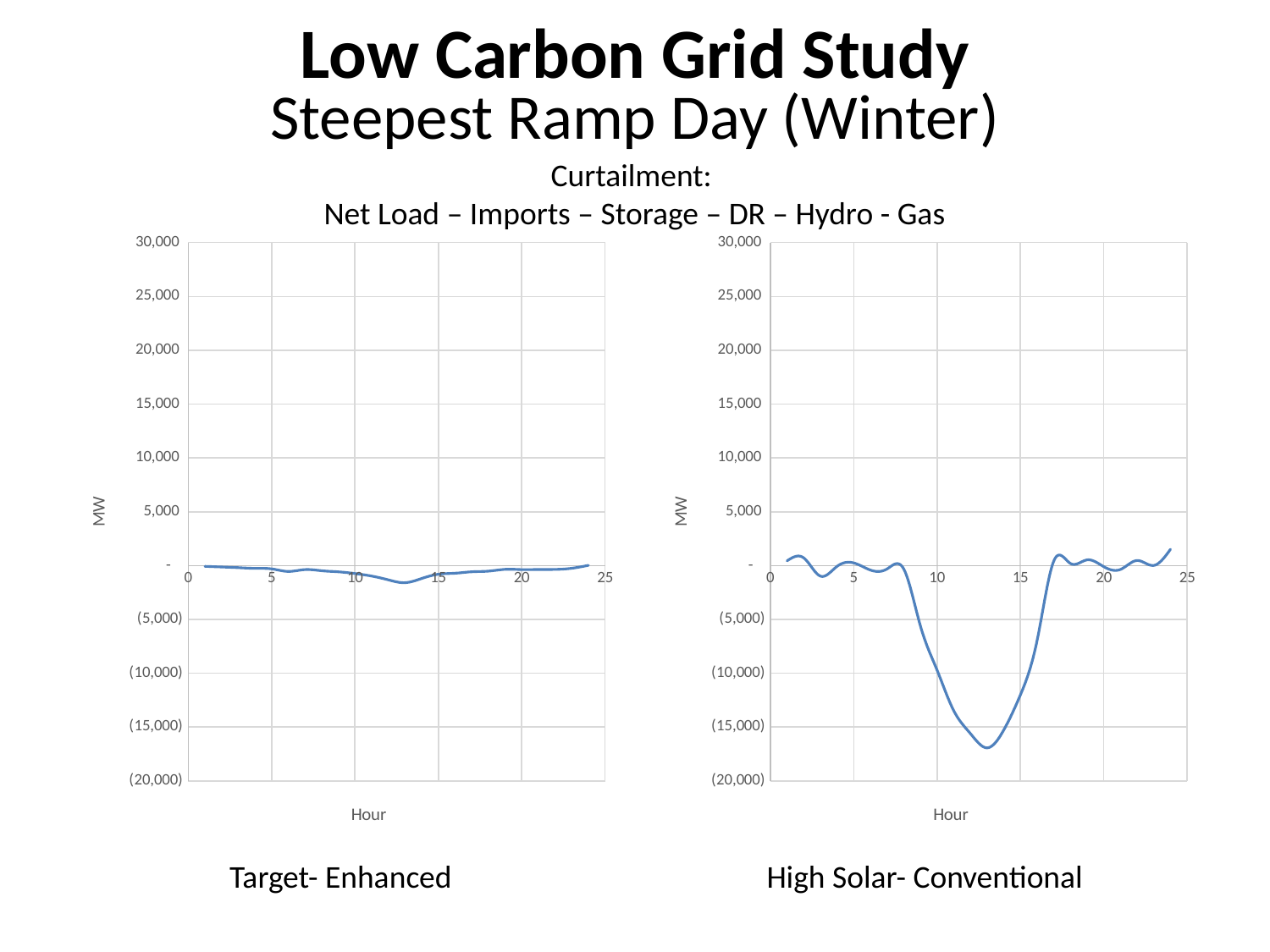
In the High Solar- Conventional chart, do the values rise or fall between hour 13 and hour 17? rise In the Target- Enhanced chart, is the value at hour 13 greater or less than (5,000)? greater What is the x-axis label on the High Solar- Conventional chart? Hour In the High Solar- Conventional chart, which is larger, the value at hour 5 or the value at hour 13? hour 5 What kind of chart is the High Solar- Conventional chart on the right? line chart What kind of chart is the Target- Enhanced chart on the left? line chart In the High Solar- Conventional chart, is the value at hour 13 greater or less than (15,000)? less In the High Solar- Conventional chart, is the value at hour 5 greater or less than (5,000)? greater What is the y-axis label on the Target- Enhanced chart? MW Comparing the two charts at hour 13, which chart shows the lower value? High Solar- Conventional In the High Solar- Conventional chart, do the values rise or fall between hour 8 and hour 13? fall